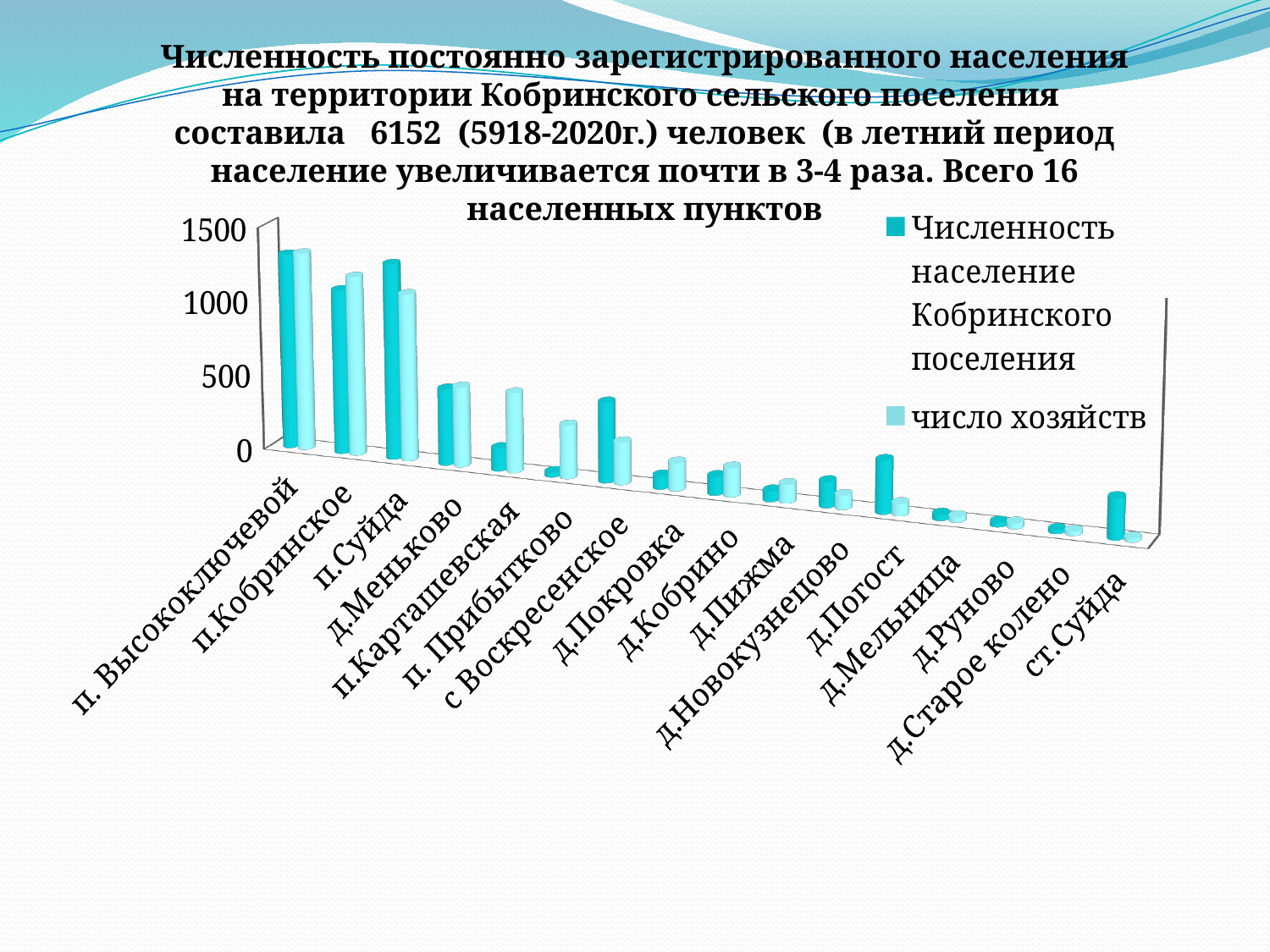
Which settlement has the highest value for число хозяйств? п. Высокоключевой Is the population value (Численность население) for п. Высокоключевой greater or less than 1000? greater Do the population values generally rise or fall moving from left to right along the x axis? fall Is the population value (Численность население) for п.Карташевская greater or less than 500? less What kind of chart is shown on the slide? bar chart Is the population value (Численность население) for п.Кобринское greater or less than 1000? greater How many series does the chart legend list? 2 For п.Карташевская, which is larger: the population (Численность население) or число хозяйств? число хозяйств How many settlements (categories) are shown on the x axis of the chart? 16 For с.Воскресенское, which is larger: the population (Численность население) or число хозяйств? Численность население What are the two series named in the chart legend? Численность население Кобринского поселения; число хозяйств